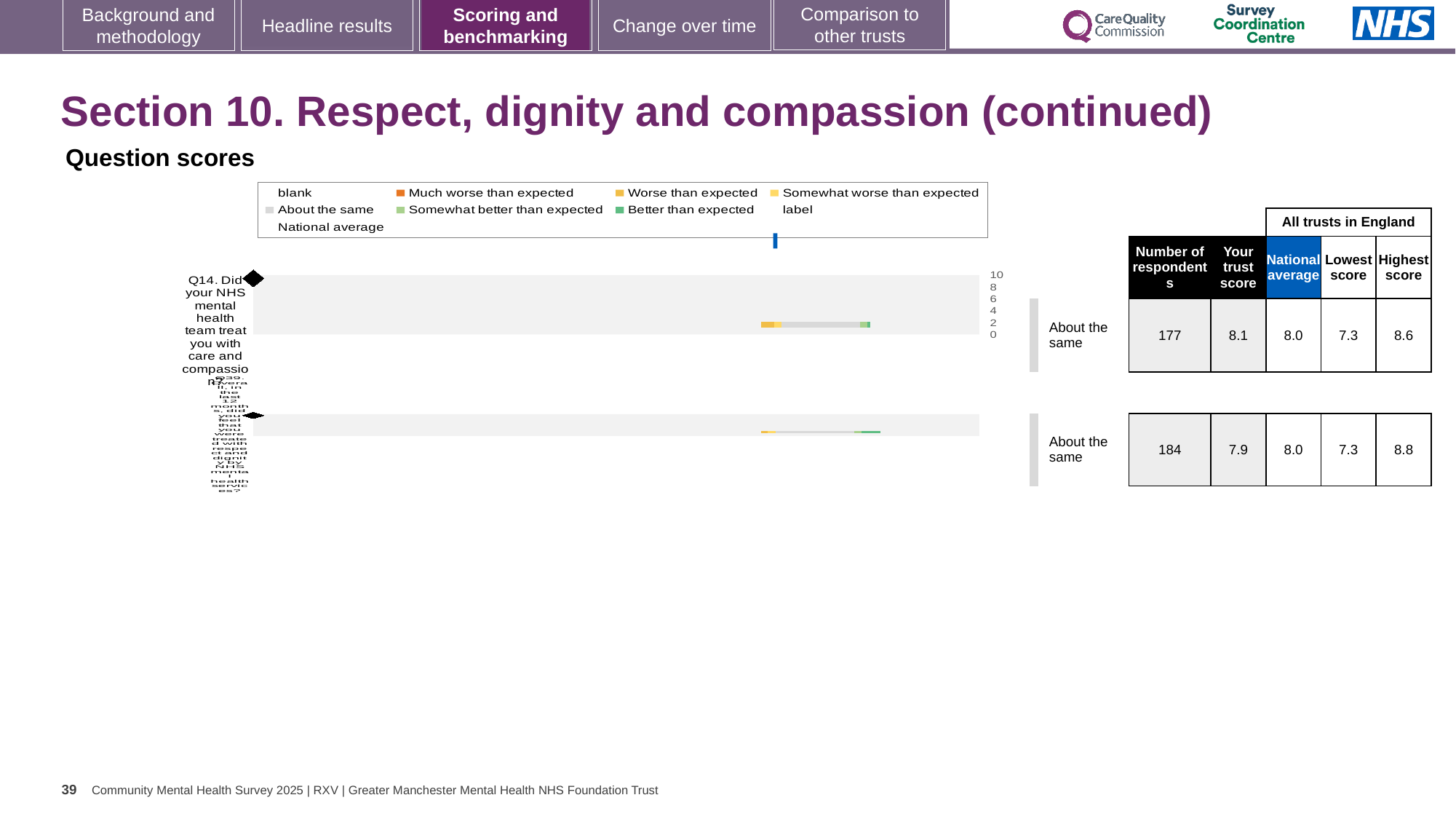
What is the highest score among all trusts in England for Q39? 8.8 How many respondents answered Q39? 184 How many questions are plotted in the question scores chart? 2 What is the difference between the trust scores for Q14 and Q39? 0.2 What is the trust score for Q39? 7.9 What benchmark category is shown for Q14? About the same What is the trust score for Q14 (Did your NHS mental health team treat you with care and compassion?)? 8.1 Which question has the higher trust score, Q14 or Q39? Q14 What is the highest tick value shown on the chart's score axis? 10 Which colour does the legend use for 'Much worse than expected'? orange What kind of chart is used to show the question scores on this slide? bar chart What is the national average score for Q14? 8.0